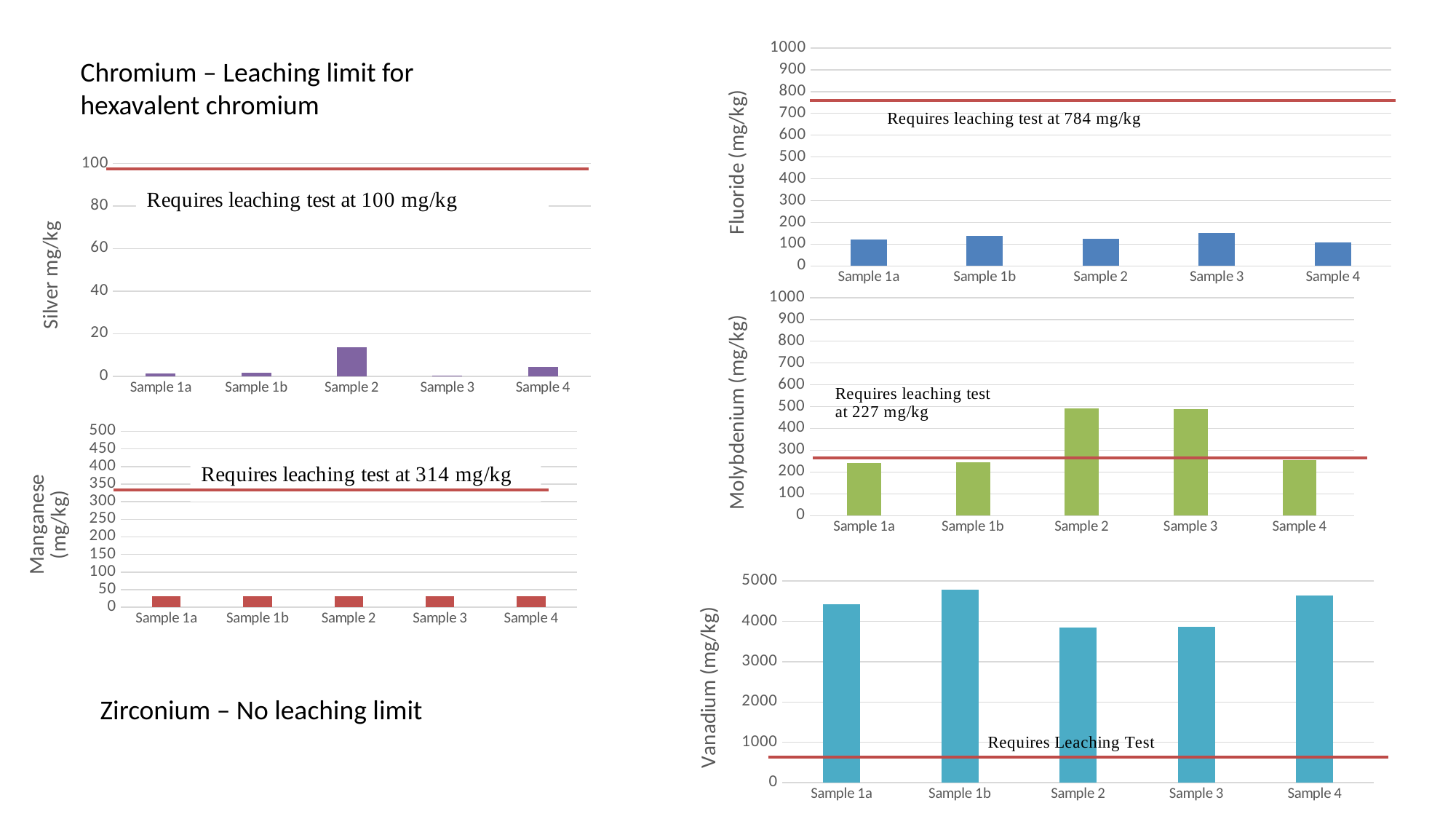
In the Fluoride (mg/kg) chart, is the value for Sample 3 greater or less than 100? greater How many samples are plotted in the Silver mg/kg chart? 5 In the Manganese (mg/kg) chart, is the value for Sample 1a greater or less than 50? less In the Molybdenium (mg/kg) chart, which is larger, Sample 2 or Sample 4? Sample 2 In the Vanadium (mg/kg) chart, which sample has the highest value? Sample 1b In the Silver mg/kg chart, which sample has the highest value? Sample 2 In the Silver mg/kg chart, is the value for Sample 2 greater or less than 20? less What kind of chart is the Manganese (mg/kg) chart? bar chart In the Fluoride (mg/kg) chart, which sample has the highest value? Sample 3 In the Fluoride (mg/kg) chart, which is larger, Sample 3 or Sample 4? Sample 3